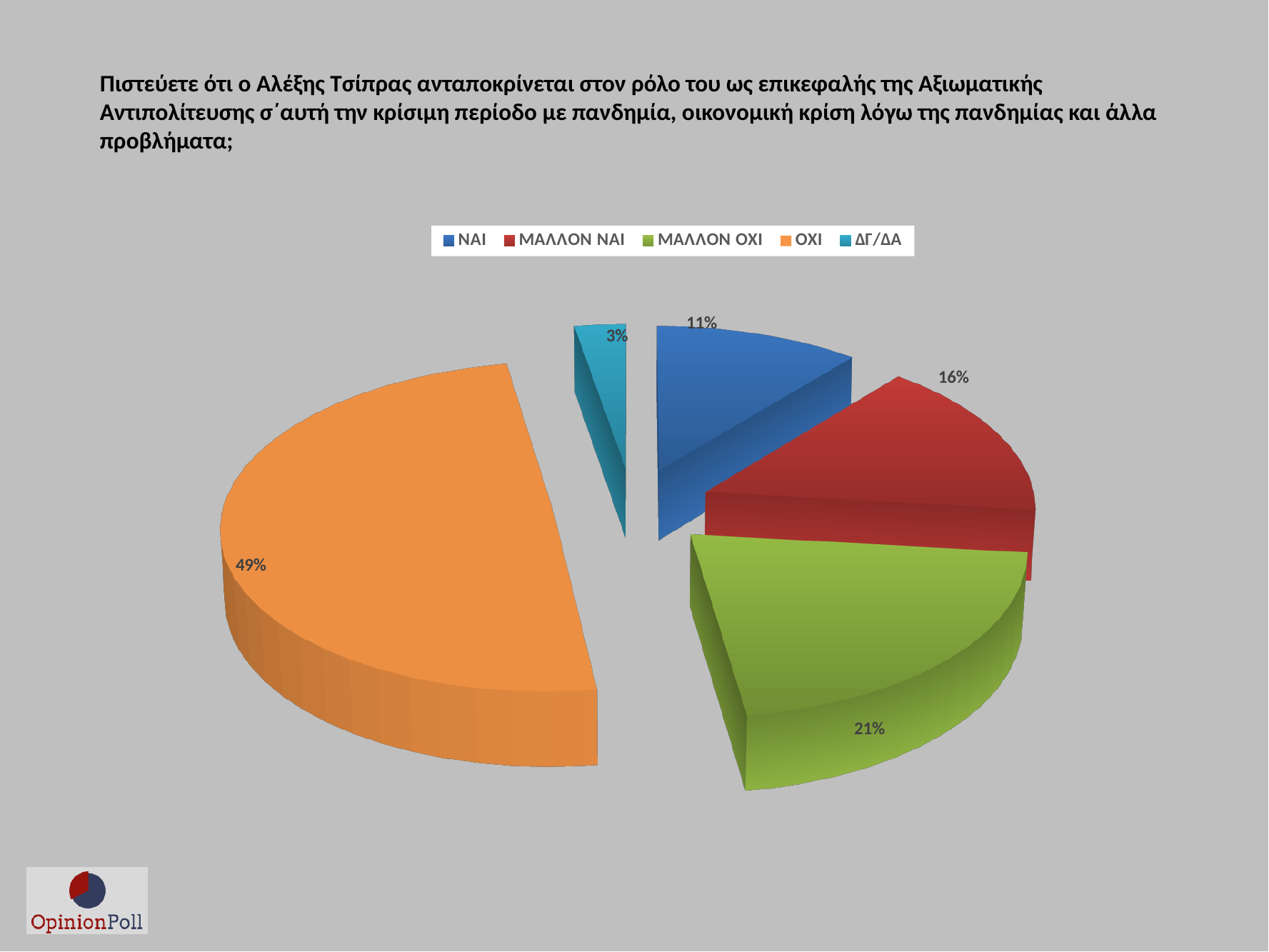
What is the value shown for ΜΑΛΛΟΝ ΟΧΙ? 21% What share of the pie does ΟΧΙ hold? 49% What colour is the ΟΧΙ slice? Orange What is the value shown for ΝΑΙ? 11% Which category has the largest slice of the pie? ΟΧΙ What is the value shown for ΔΓ/ΔΑ? 3% How many categories does the pie chart show? 5 Which category has the smallest slice of the pie? ΔΓ/ΔΑ What is the value shown for ΜΑΛΛΟΝ ΝΑΙ? 16% What is the difference between the ΟΧΙ and ΜΑΛΛΟΝ ΟΧΙ values? 28% Which is larger, ΜΑΛΛΟΝ ΝΑΙ or ΝΑΙ? ΜΑΛΛΟΝ ΝΑΙ What kind of chart is shown on the slide? Pie chart